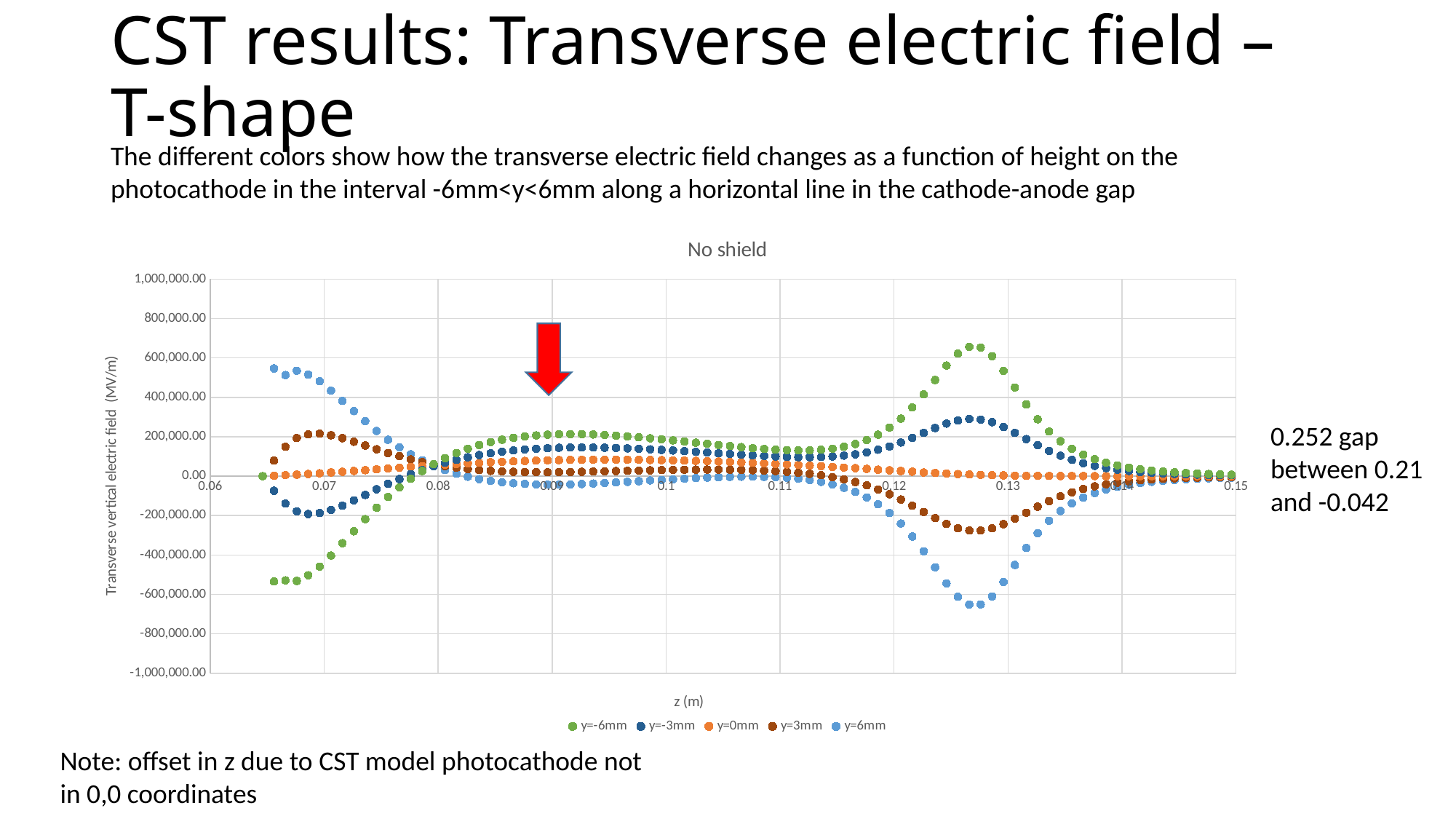
Is the value of the y=3mm series at z=0.07 greater or less than 0.00? greater Which series reaches the lowest value on the chart? y=6mm How many series does the chart legend list? 5 Is the minimum value of the y=6mm series near z=0.125 greater or less than -400,000.00? less Does the y=-6mm series rise or fall between z=0.11 and z=0.125? rise Which series reaches the highest value on the chart? y=-6mm At z=0.07, which series has the larger value: y=6mm or y=3mm? y=6mm Is the peak value of the y=-6mm series near z=0.125 greater or less than 400,000.00? greater What is the title of the chart? No shield What is the label of the x axis of the chart? z (m) What kind of chart is shown on the slide? scatter chart